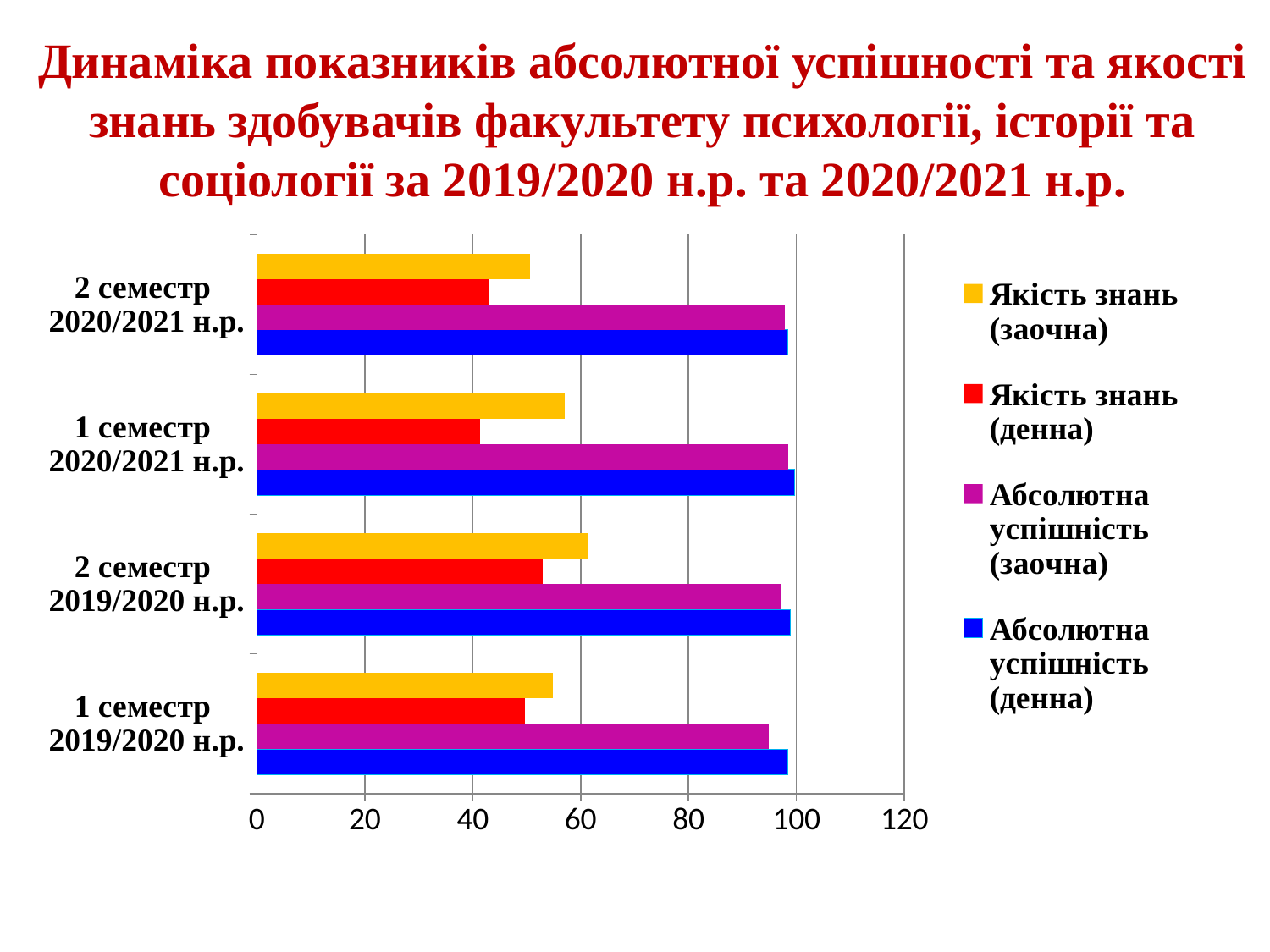
Is the value for Якість знань (денна) in 1 семестр 2020/2021 н.р. greater or less than 60? less How many semester categories are shown on the chart? 4 What colour represents Якість знань (денна) in the legend? red What kind of chart is shown on the slide? bar chart Is the value for Якість знань (денна) in 2 семестр 2019/2020 н.р. greater or less than 40? greater In which semester is Якість знань (заочна) highest? 2 семестр 2019/2020 н.р. Is the value for Якість знань (заочна) in 2 семестр 2020/2021 н.р. greater or less than 60? less In 2 семестр 2019/2020 н.р., which is larger: Якість знань (заочна) or Якість знань (денна)? Якість знань (заочна) In 1 семестр 2020/2021 н.р., which is larger: Абсолютна успішність (денна) or Якість знань (денна)? Абсолютна успішність (денна) How many series does the legend list? 4